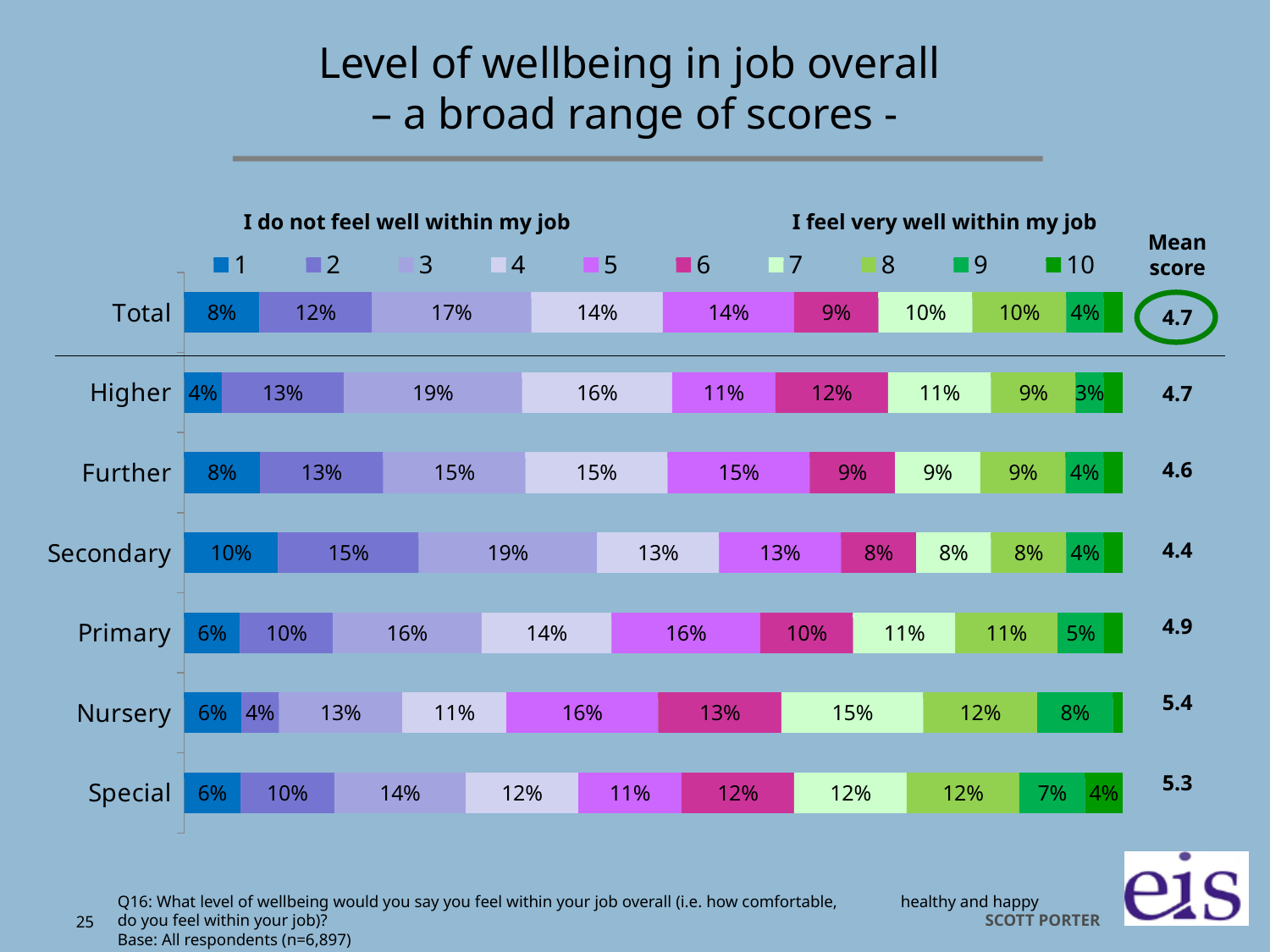
What percentage of Total respondents gave a score of 3? 17% What is the mean score shown for Nursery? 5.4 How many sector categories (including Total) are plotted on the chart? 7 What is the difference between the score-3 percentage for Secondary and for Nursery? 6 percentage points What percentage of Secondary respondents gave a score of 1? 10% Which sector has the highest percentage giving a score of 1? Secondary Which sector has the lowest percentage giving a score of 1? Higher What percentage of Primary respondents gave a score of 5? 16% Which has a larger percentage giving a score of 8: Primary or Secondary? Primary What kind of chart is shown on the slide? Stacked bar chart How many series does the legend list? 10